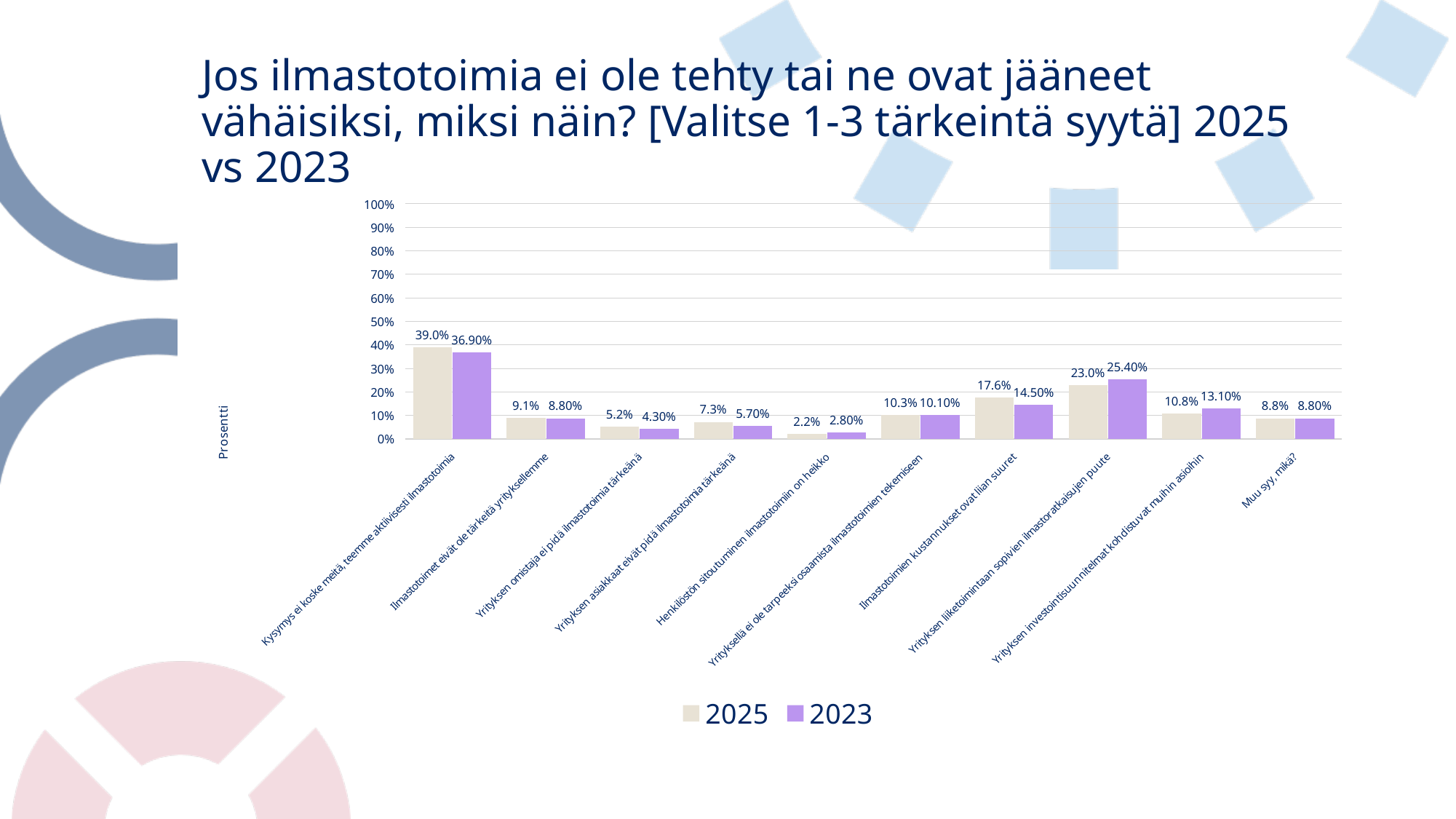
What is the 2025 value for "Kysymys ei koske meitä, teemme aktiivisesti ilmastotoimia"? 39.0% What is the 2025 value for "Ilmastotoimien kustannukset ovat liian suuret"? 17.6% What is the 2023 value for "Yrityksen liiketoimintaan sopivien ilmastoratkaisujen puute"? 25.40% Is the 2023 value for "Kysymys ei koske meitä, teemme aktiivisesti ilmastotoimia" greater or less than 30%? greater What is the label of the vertical axis? Prosentti Which category has the lowest 2023 value? Henkilöstön sitoutuminen ilmastotoimiin on heikko Which category has the highest 2025 value? Kysymys ei koske meitä, teemme aktiivisesti ilmastotoimia What is the difference between the 2025 and 2023 values for "Ilmastotoimien kustannukset ovat liian suuret"? 3.1 percentage points How many categories are shown on the x axis? 10 What kind of chart is shown on the slide? Bar chart How many series does the legend list? 2 For "Yrityksen investointisuunnitelmat kohdistuvat muihin asioihin", which year has the larger value, 2025 or 2023? 2023